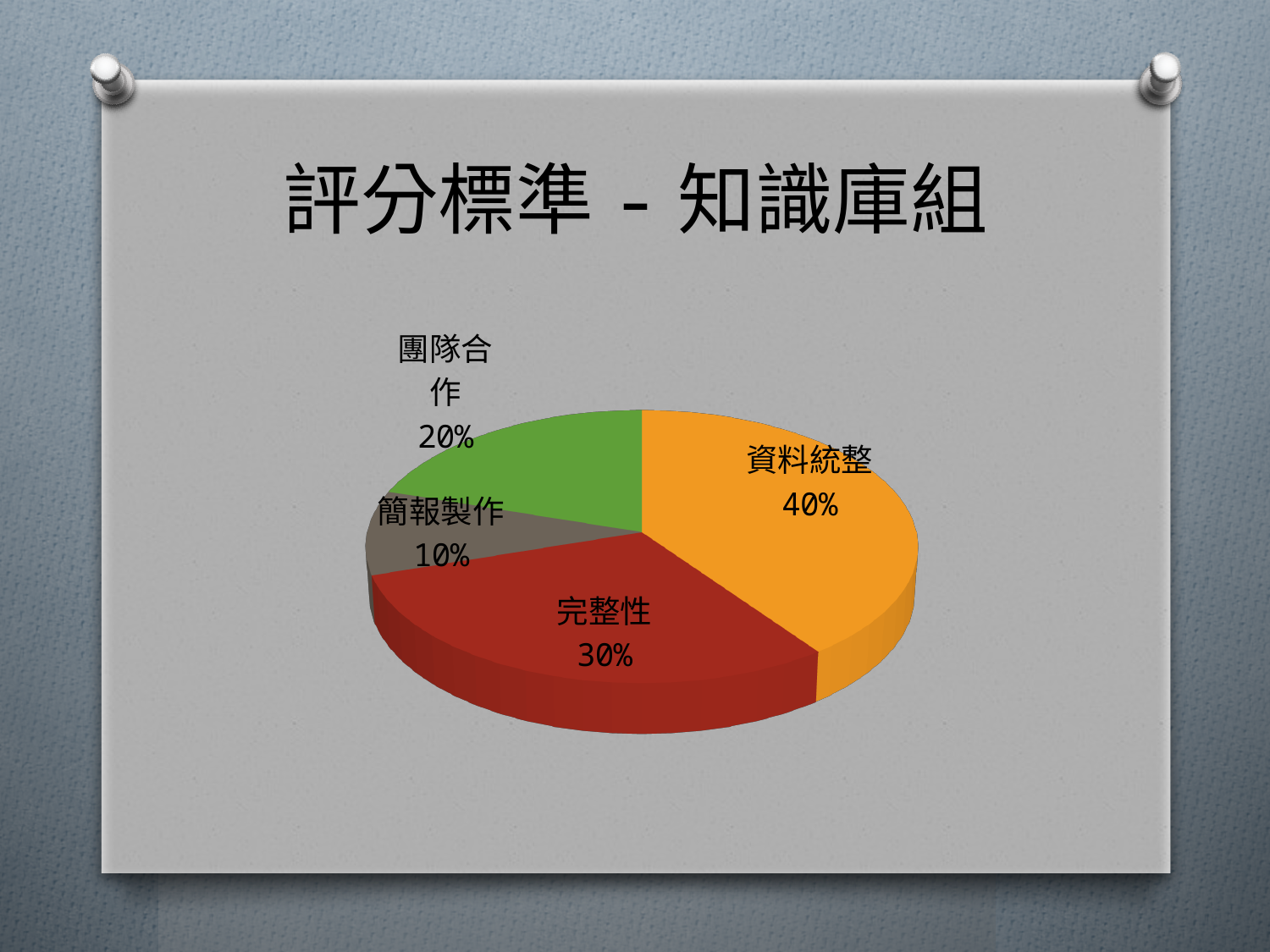
What is the value for 簡報製作? 10% Which category has the smallest share of the pie? 簡報製作 What is the difference between the values for 資料統整 and 完整性? 10% What is the value for 團隊合作? 20% What is the title of the slide containing the chart? 評分標準 - 知識庫組 Which is larger, the value for 團隊合作 or the value for 簡報製作? 團隊合作 Which category has the largest share of the pie? 資料統整 What kind of chart is shown on the slide? pie chart What is the value for 資料統整? 40% What colour is the slice for 完整性? red How many slices does the pie chart have? 4 What is the value for 完整性? 30%